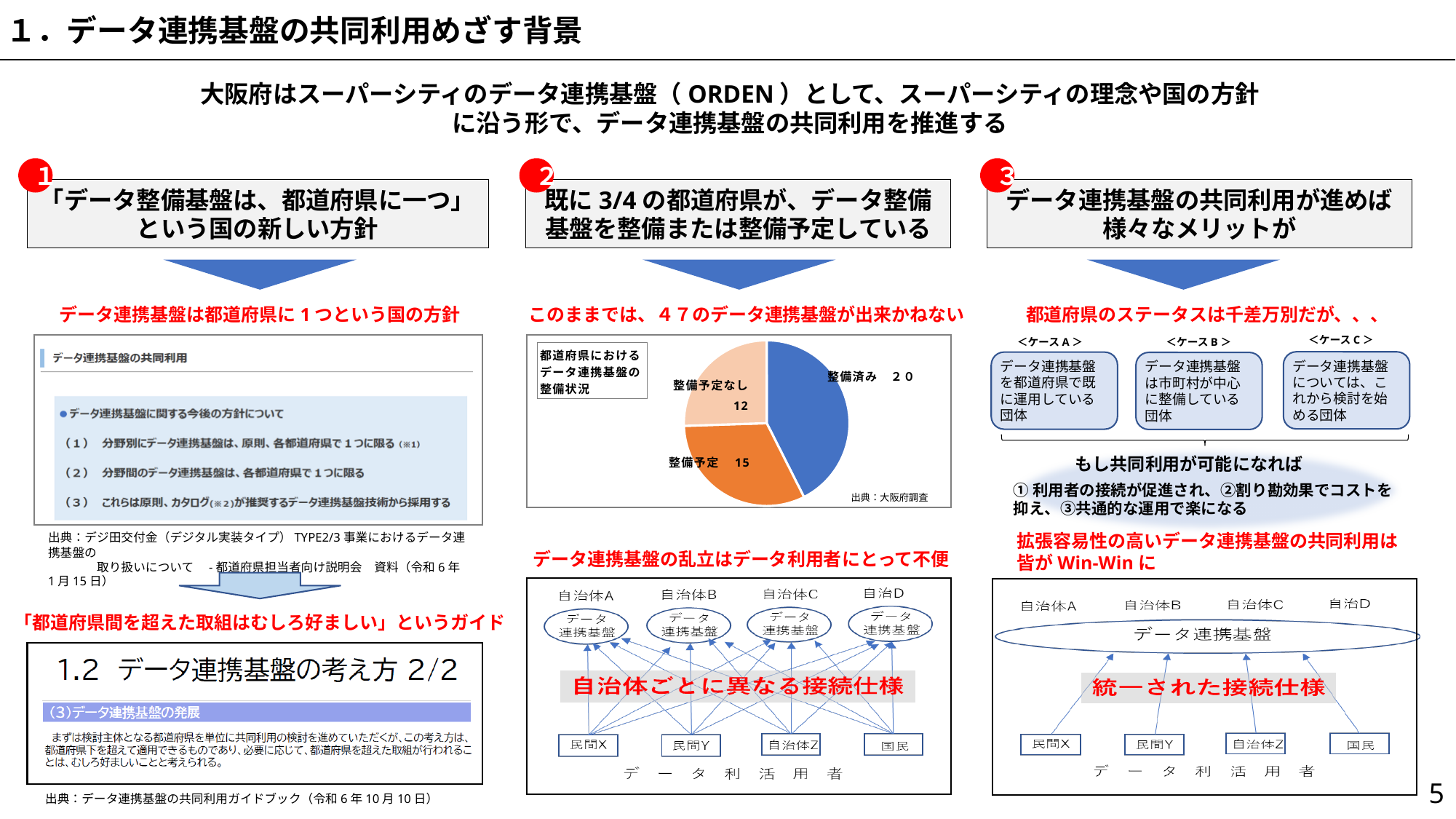
In the pie chart 「都道府県におけるデータ連携基盤の整備状況」, what is the difference between 整備予定 and 整備予定なし? 3 In the pie chart 「都道府県におけるデータ連携基盤の整備状況」, what is the value for 整備予定なし? 12 What is the total of all slices in the pie chart 「都道府県におけるデータ連携基盤の整備状況」? 47 In the pie chart 「都道府県におけるデータ連携基盤の整備状況」, which category has the smallest slice? 整備予定なし In the pie chart 「都道府県におけるデータ連携基盤の整備状況」, which is larger, 整備済み or 整備予定? 整備済み How many categories does the pie chart 「都道府県におけるデータ連携基盤の整備状況」 have? 3 In the pie chart 「都道府県におけるデータ連携基盤の整備状況」, what colour is the 整備済み slice? Blue In the pie chart 「都道府県におけるデータ連携基盤の整備状況」, what is the difference between 整備済み and 整備予定なし? 8 In the pie chart 「都道府県におけるデータ連携基盤の整備状況」, which category has the largest slice? 整備済み In the pie chart 「都道府県におけるデータ連携基盤の整備状況」, what is the value for 整備済み? 20 In the pie chart 「都道府県におけるデータ連携基盤の整備状況」, what is the value for 整備予定? 15 What kind of chart is shown in the middle column under 「このままでは、４７のデータ連携基盤が出来かねない」? Pie chart